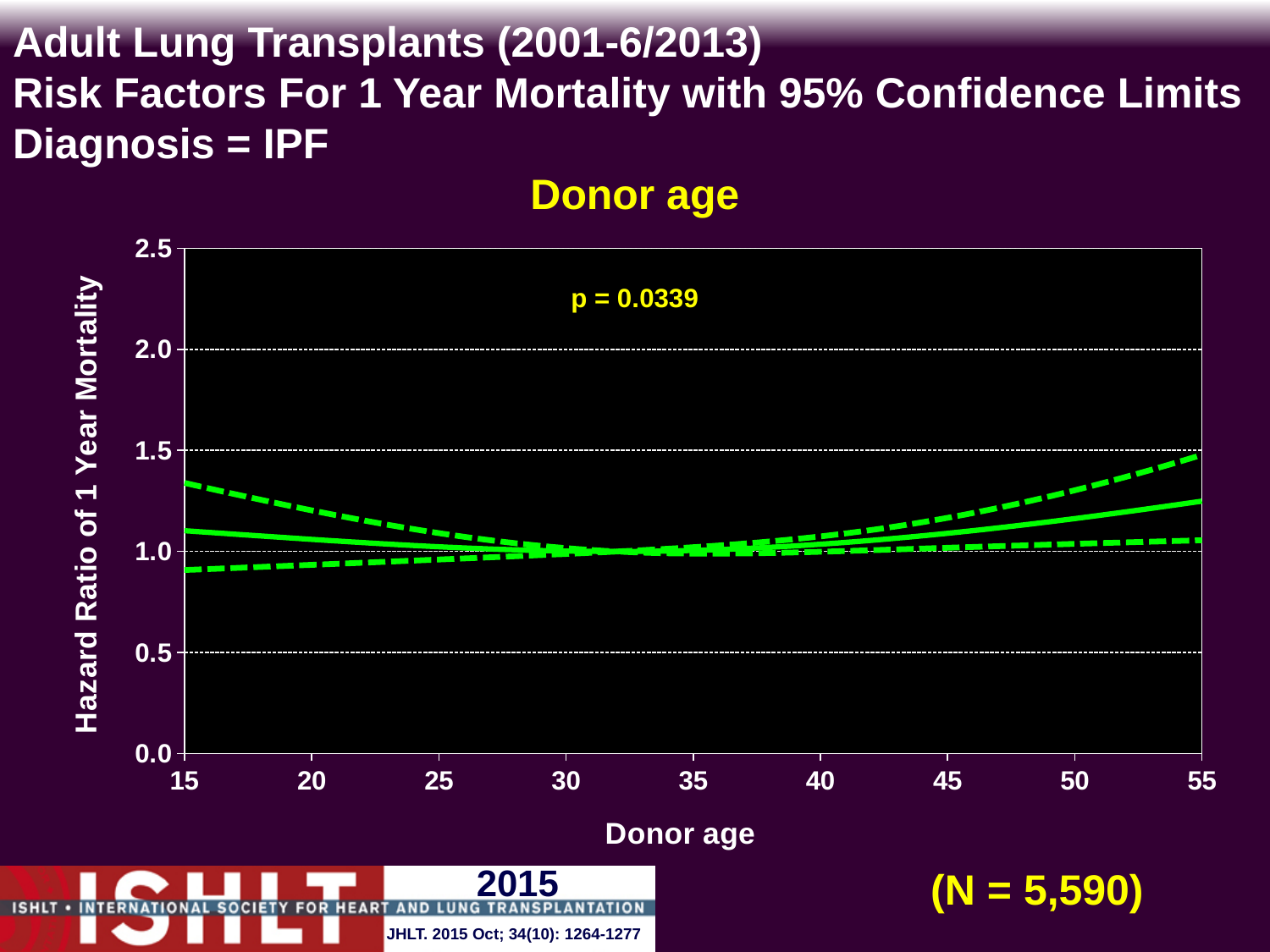
Between donor age 35 and donor age 55, does the solid hazard ratio line rise or fall? rise What kind of chart is shown on the slide? Line chart Is the solid hazard ratio line at donor age 55 greater or less than 1.5? less Is the hazard ratio of the solid line at donor age 55 greater or less than 1.0? greater Is the lower dashed confidence limit at donor age 15 greater or less than 1.0? less What p-value is printed on the chart? p = 0.0339 What is the title of the chart? Donor age How many lines are plotted on the chart? 3 Between donor age 15 and donor age 30, does the solid hazard ratio line rise or fall? fall How many tick labels are shown on the x axis (Donor age)? 9